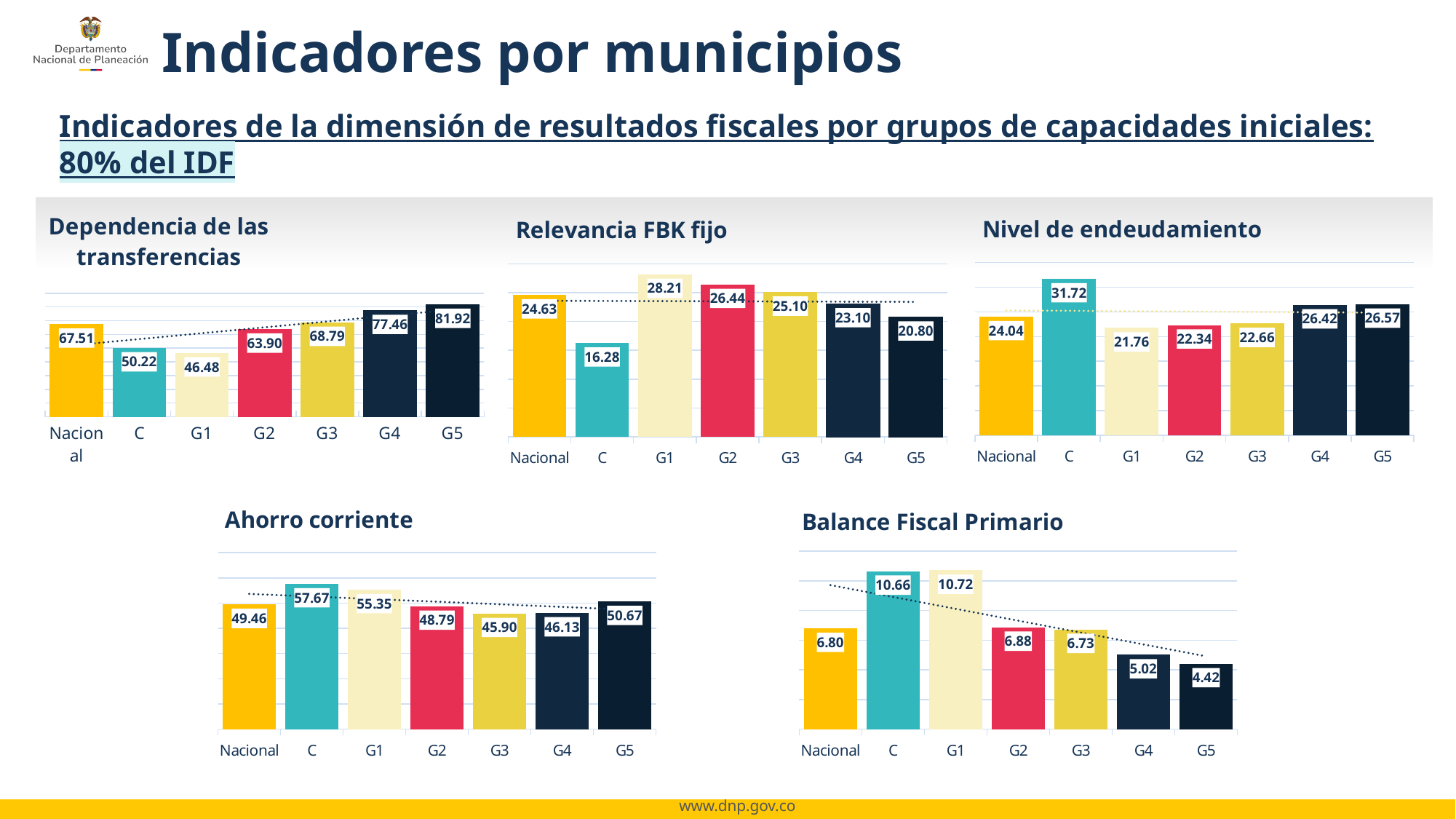
In the 'Dependencia de las transferencias' chart, what is the value for G4? 77.46 In the 'Ahorro corriente' chart, which is larger, the value for C or the value for G2? C In the 'Dependencia de las transferencias' chart, which category has the highest value? G5 In the 'Relevancia FBK fijo' chart, which category has the lowest value? C In the 'Relevancia FBK fijo' chart, what is the value for Nacional? 24.63 How many categories are shown in the 'Balance Fiscal Primario' chart? 7 In the 'Ahorro corriente' chart, what is the value for G3? 45.90 In the 'Nivel de endeudamiento' chart, which category has the highest value? C In the 'Balance Fiscal Primario' chart, which category has the lowest value? G5 In the 'Balance Fiscal Primario' chart, what is the value for G4? 5.02 In the 'Nivel de endeudamiento' chart, what is the difference between the values for C and Nacional? 7.68 What kind of chart is 'Ahorro corriente'? Bar chart